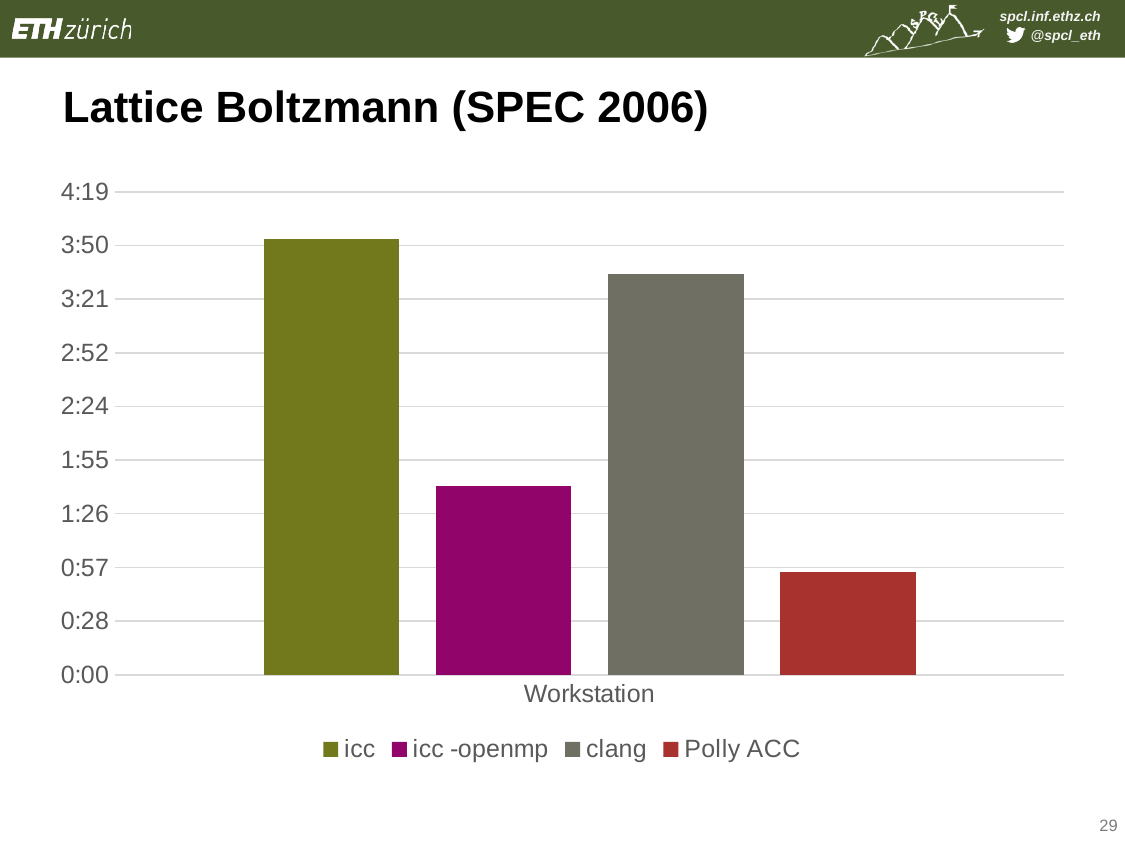
Which series has the highest bar? icc What is the label of the category on the x axis? Workstation Which series has the lowest bar? Polly ACC Is the value for Polly ACC greater or less than 1:26? less Is the value for clang greater or less than 3:21? greater How many categories are shown on the x axis? 1 How many series does the legend list? 4 What kind of chart is shown on the slide? bar chart Is the value for icc -openmp greater or less than 1:55? less Which is larger, the value for icc or the value for clang? icc Which is larger, the value for icc -openmp or the value for Polly ACC? icc -openmp What is the title of the chart? Lattice Boltzmann (SPEC 2006)